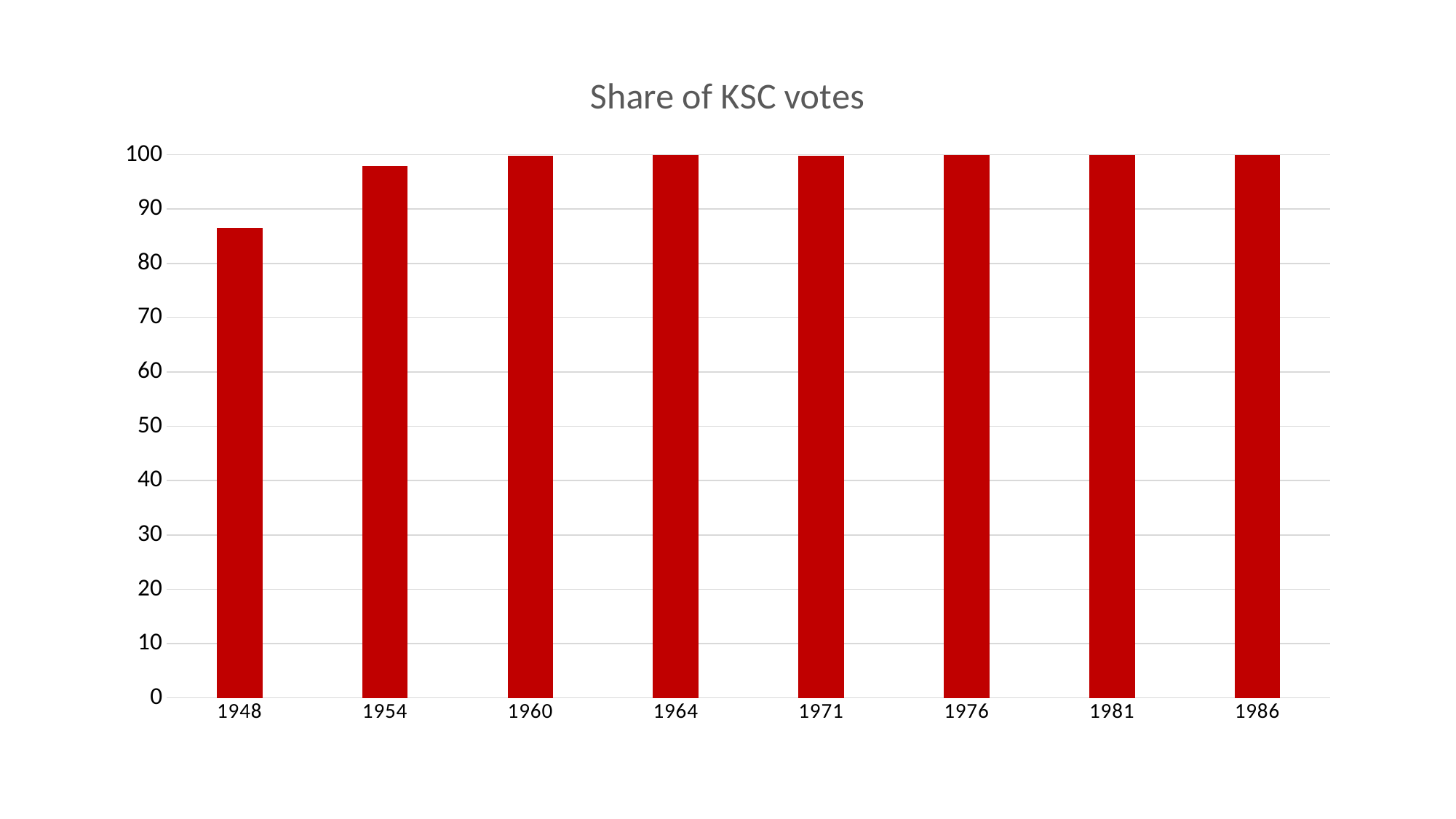
Do the values generally rise or fall from 1948 to 1986? rise What is the title of the chart? Share of KSC votes What colour are the bars in the chart? red How many years are shown on the x axis of the chart? 8 Is the value for 1948 greater or less than 90? less Which is larger, the value for 1948 or the value for 1954? 1954 Is the value for 1954 greater or less than 90? greater Which year has the lowest share of KSC votes? 1948 What kind of chart is shown on the slide? bar chart Is the value for 1971 greater or less than 90? greater Which is larger, the value for 1948 or the value for 1986? 1986